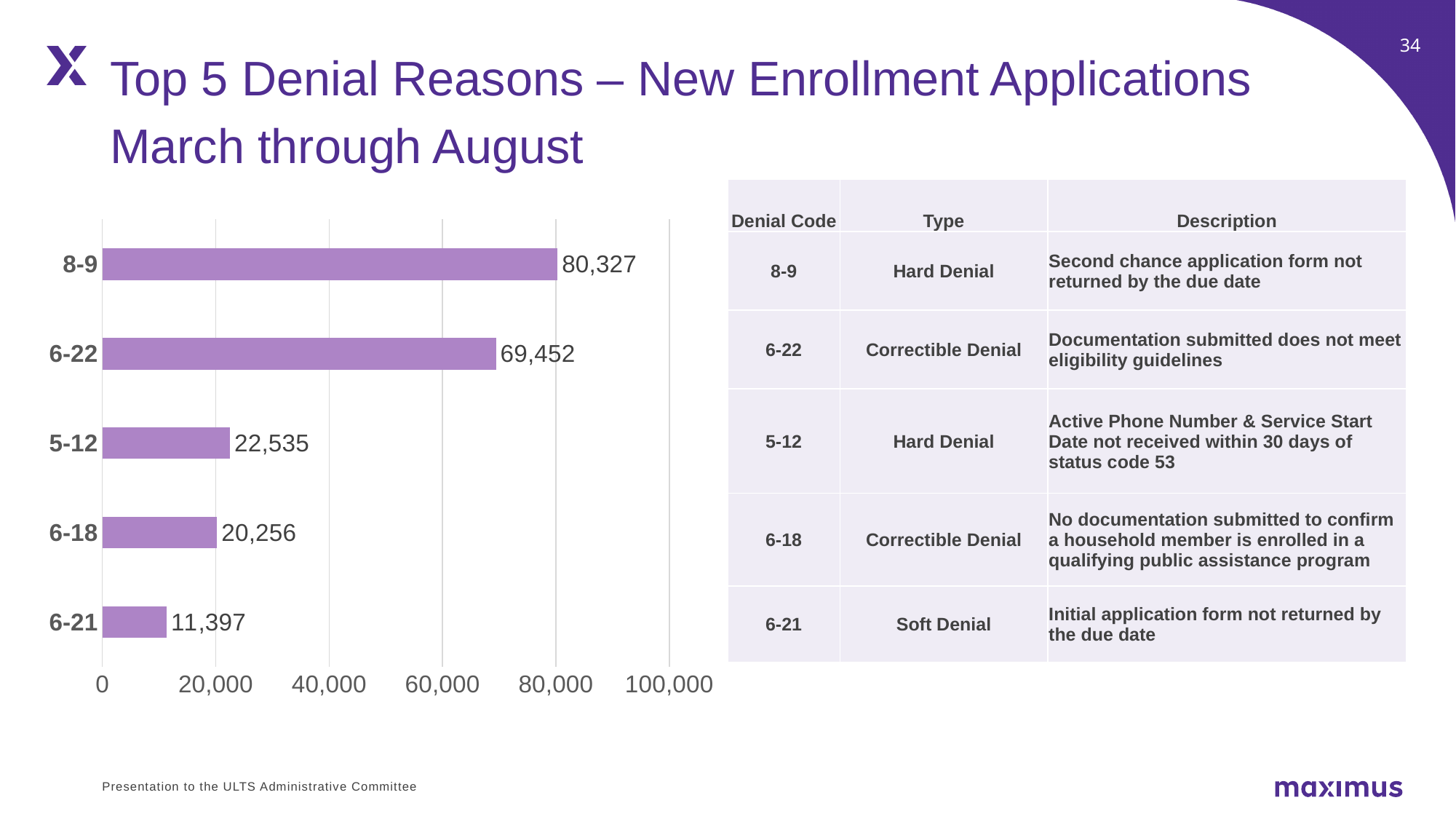
What is the difference between the values for 5-12 and 6-18? 2,279 Which is larger, the value for 6-18 or the value for 6-21? 6-18 Is the value for 6-22 greater or less than 60,000? greater What is the value for denial code 5-12? 22,535 What is the value for denial code 8-9? 80,327 What is the value for denial code 6-22? 69,452 What is the value for denial code 6-21? 11,397 What kind of chart is shown on the slide? Bar chart Which denial code has the highest value? 8-9 What is the difference between the values for 8-9 and 6-22? 10,875 How many denial codes are shown in the chart? 5 Which denial code has the lowest value? 6-21